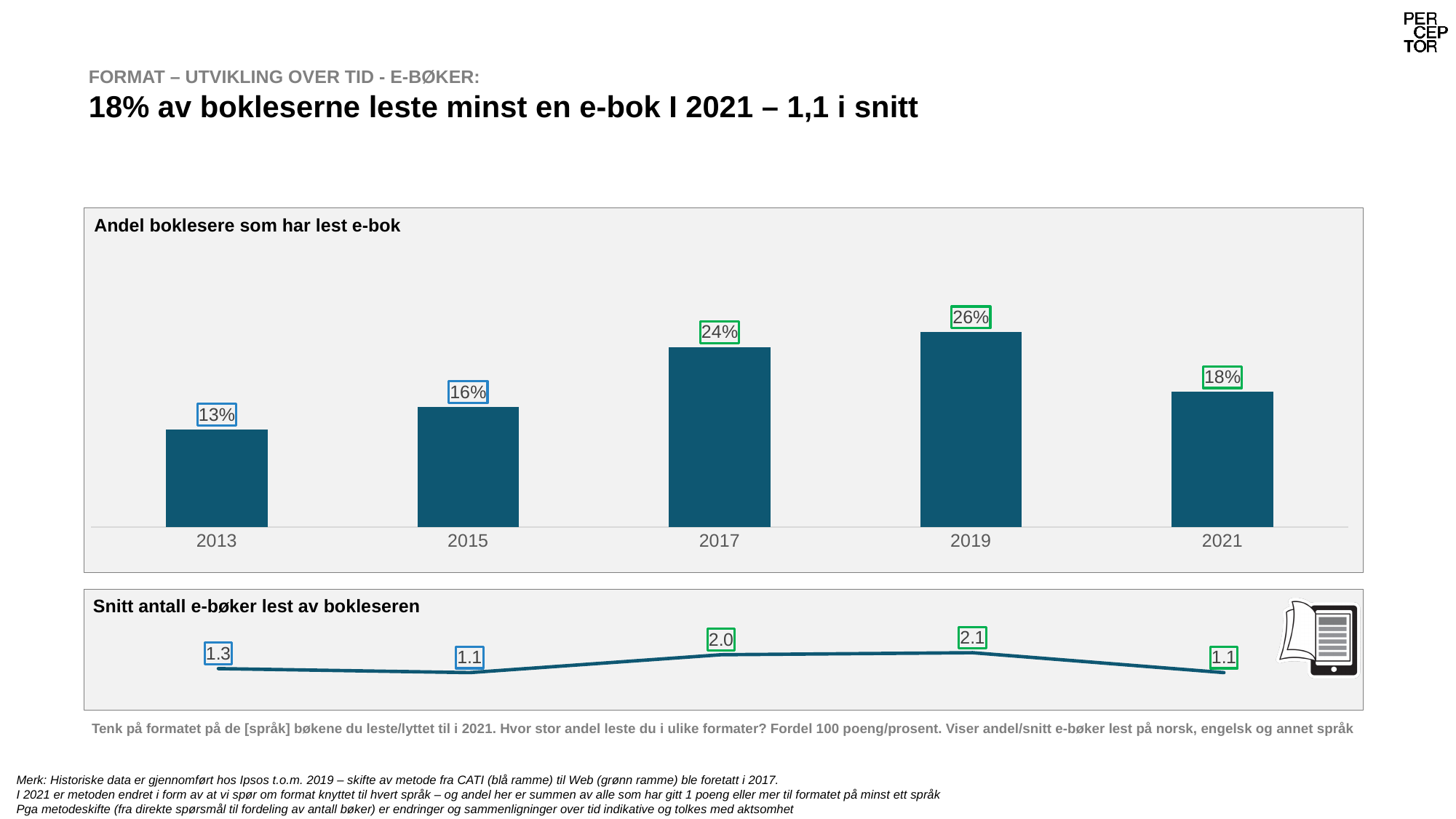
In the chart 'Andel boklesere som har lest e-bok', which year has the lowest value? 2013 What kind of chart is 'Andel boklesere som har lest e-bok'? Bar chart How many years are shown in the chart 'Andel boklesere som har lest e-bok'? 5 In the chart 'Andel boklesere som har lest e-bok', which is larger, the value for 2015 or the value for 2021? 2021 In the chart 'Andel boklesere som har lest e-bok', what is the value for 2013? 13% In the chart 'Snitt antall e-bøker lest av bokleseren', what is the value for 2013? 1.3 In the chart 'Andel boklesere som har lest e-bok', what is the difference between the values for 2019 and 2021? 8% In the chart 'Snitt antall e-bøker lest av bokleseren', what is the value for 2019? 2.1 In the chart 'Snitt antall e-bøker lest av bokleseren', what is the difference between the values for 2017 and 2015? 0.9 What kind of chart is 'Snitt antall e-bøker lest av bokleseren'? Line chart In the chart 'Andel boklesere som har lest e-bok', what is the value for 2017? 24% In the chart 'Andel boklesere som har lest e-bok', which year has the highest value? 2019